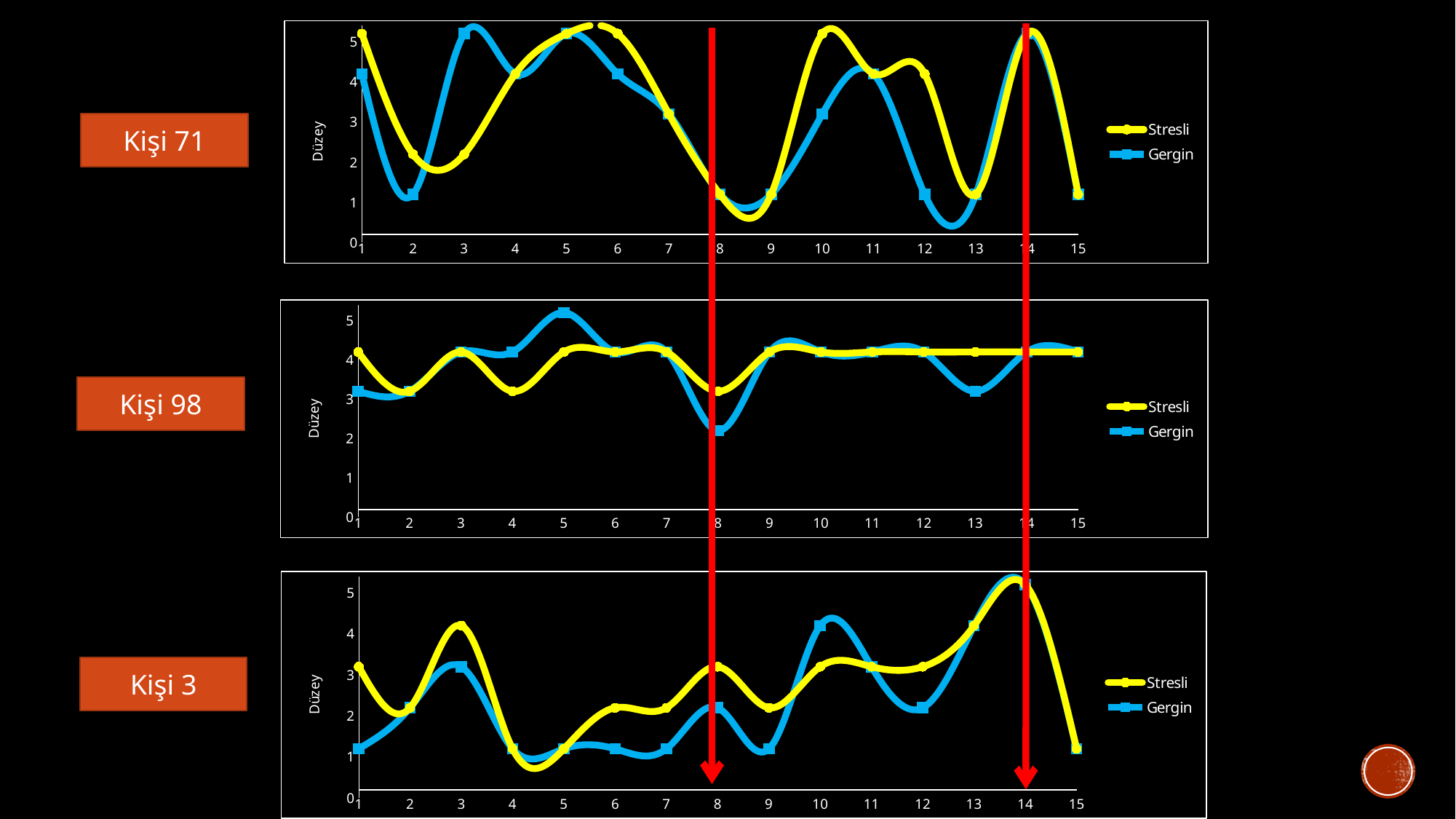
In the Kişi 71 chart, what is the difference between the Stresli and Gergin values at point 12? 3 In the Kişi 3 chart, which series has the higher value at point 10, Stresli or Gergin? Gergin In the Kişi 3 chart, what is the Stresli value at point 14? 5 In the Kişi 98 chart, at which point does the Gergin series reach its lowest value? 8 In the Kişi 98 chart, what is the Gergin value at point 8? 2 In the Kişi 71 chart, what is the Stresli value at point 10? 5 In the Kişi 98 chart, what is the Gergin value at point 5? 5 In the Kişi 3 chart, how many points are plotted along the x axis for each series? 15 In the Kişi 98 chart, how many series does the legend list? 2 In the Kişi 71 chart, what is the Gergin value at point 3? 5 In the Kişi 3 chart, what is the label on the vertical axis? Düzey In the Kişi 71 chart, what kind of chart is shown? line chart